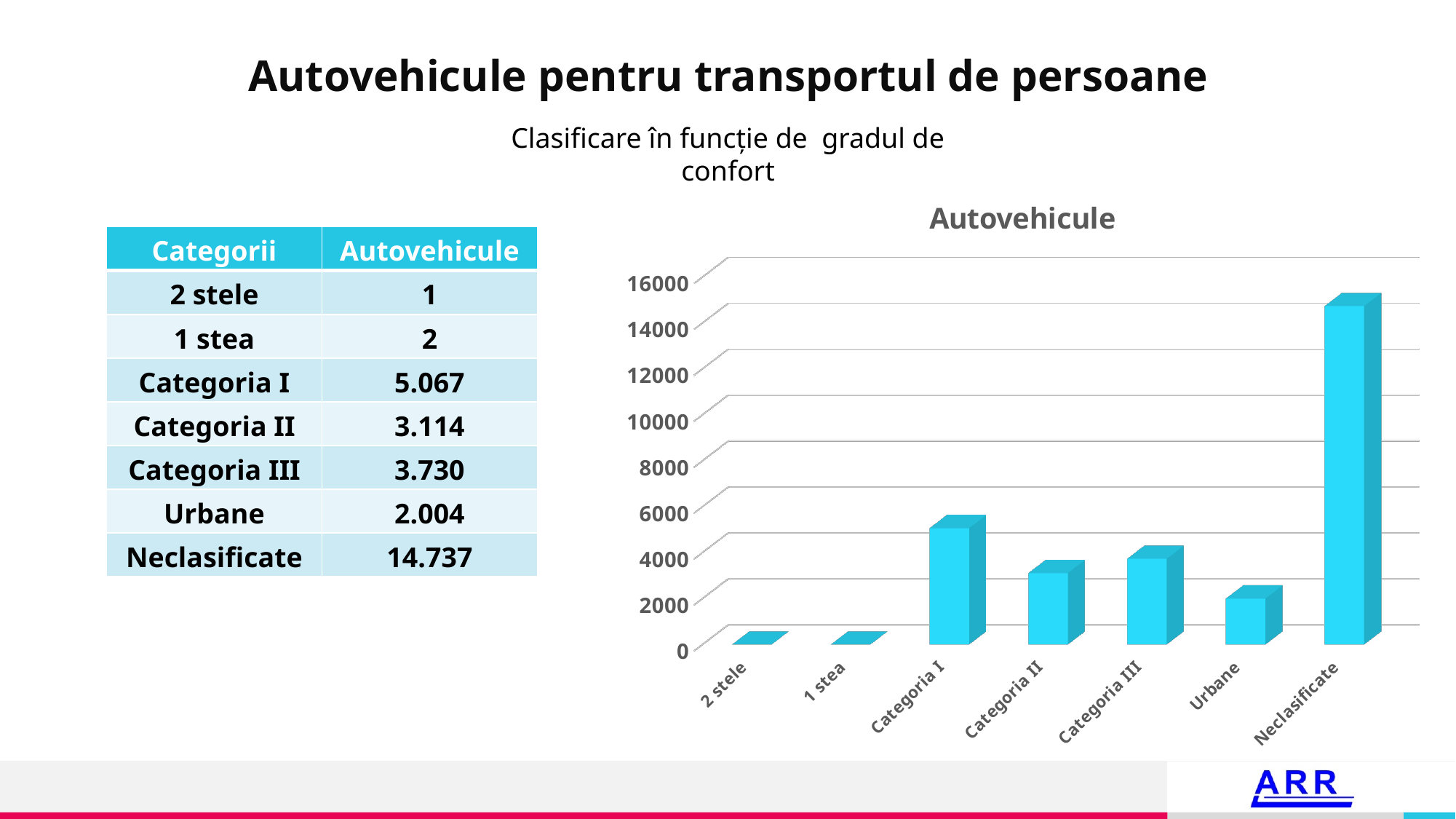
What is the title of the chart? Autovehicule What is the value for Neclasificate? 14.737 Which category has the highest value in the chart? Neclasificate What type of chart is shown on the slide? bar chart How many categories are plotted on the chart? 7 What is the value for Urbane? 2.004 What is the difference between the values for Categoria III and Categoria II? 616 Is the value for Neclasificate greater or less than 14000? greater Which category has the lowest value in the chart? 2 stele What is the value for Categoria I? 5.067 Which is larger, the value for Categoria II or the value for Categoria III? Categoria III Is the value for Categoria I greater or less than 6000? less